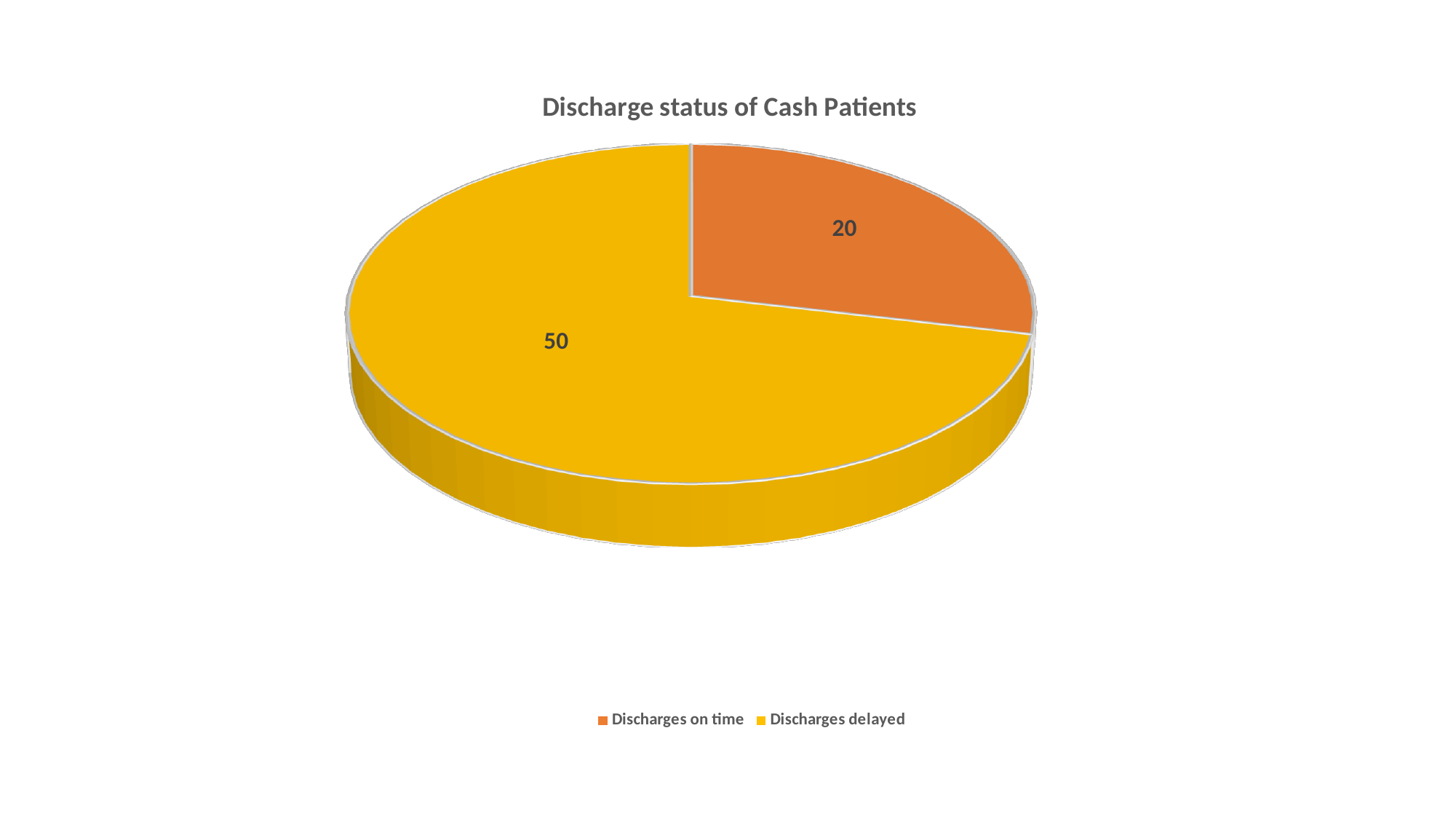
How many entries does the legend list? 2 What kind of chart is shown on the slide? Pie chart How many categories does the pie chart show? 2 Which category has the largest slice of the pie? Discharges delayed What is the value for Discharges delayed? 50 Which is larger, Discharges on time or Discharges delayed? Discharges delayed What is the value for Discharges on time? 20 What is the total of all slices in the pie chart? 70 What colour is the Discharges delayed slice? Yellow Which category has the smallest slice of the pie? Discharges on time What is the difference between Discharges delayed and Discharges on time? 30 What is the title of the chart? Discharge status of Cash Patients